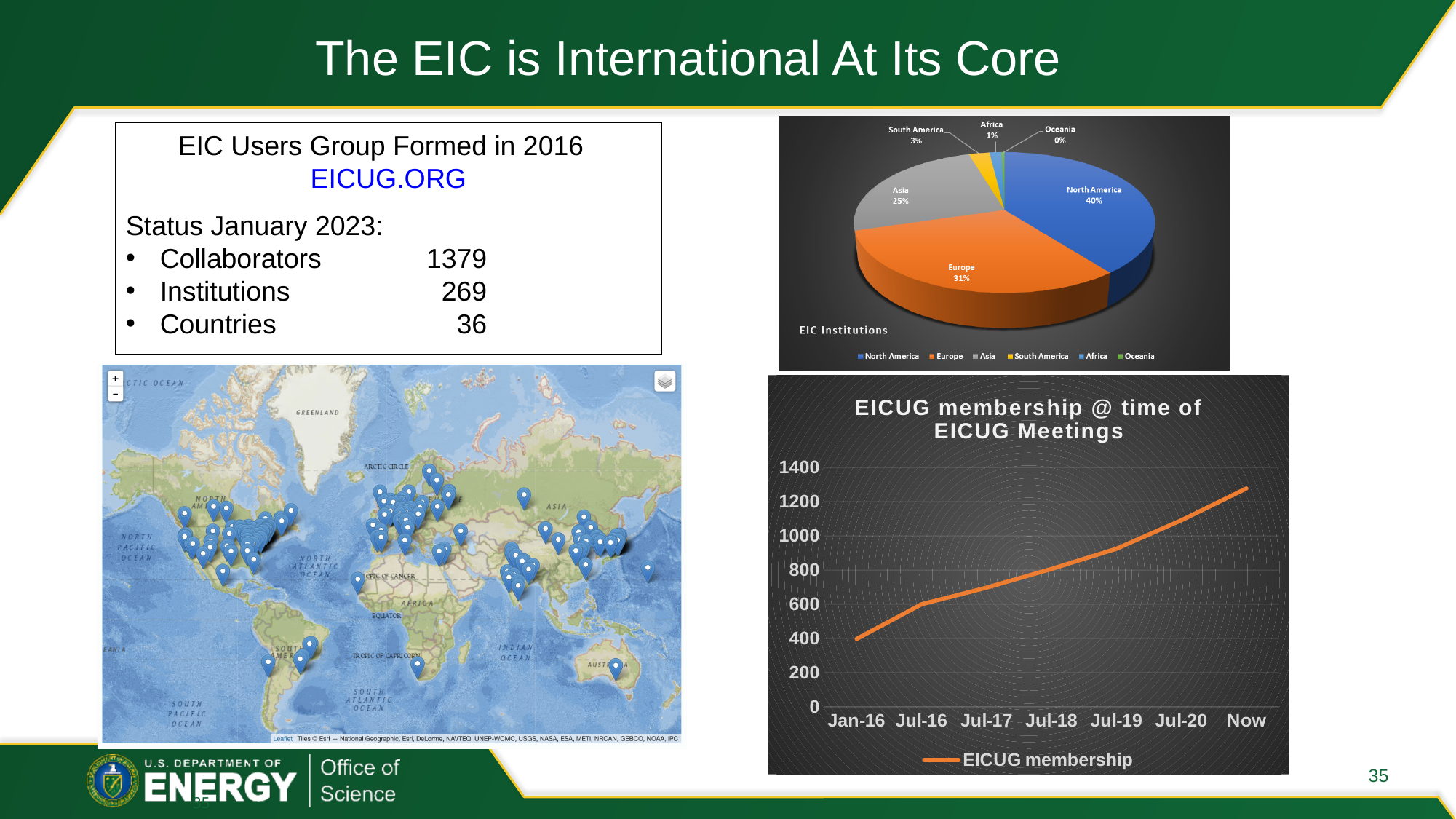
In the EICUG membership chart, how many series does the legend list? 1 In the EIC Institutions pie chart, what is the difference in percentage points between Europe and Asia? 6 In the EICUG membership chart, do the values rise or fall from Jan-16 to Now? rise In the EICUG membership chart, is the value for Now greater or less than 1200? greater In the EIC Institutions pie chart, what share of institutions is from North America? 40% In the EIC Institutions pie chart, how many regions does the legend list? 6 In the EIC Institutions pie chart, which region has the smallest share? Oceania What kind of chart is the EIC Institutions chart? Pie chart In the EIC Institutions pie chart, what share of institutions is from Europe? 31% In the EIC Institutions pie chart, which region has the largest share? North America In the EIC Institutions pie chart, what share of institutions is from Asia? 25% In the EICUG membership chart, is the value for Jan-16 greater or less than 600? less